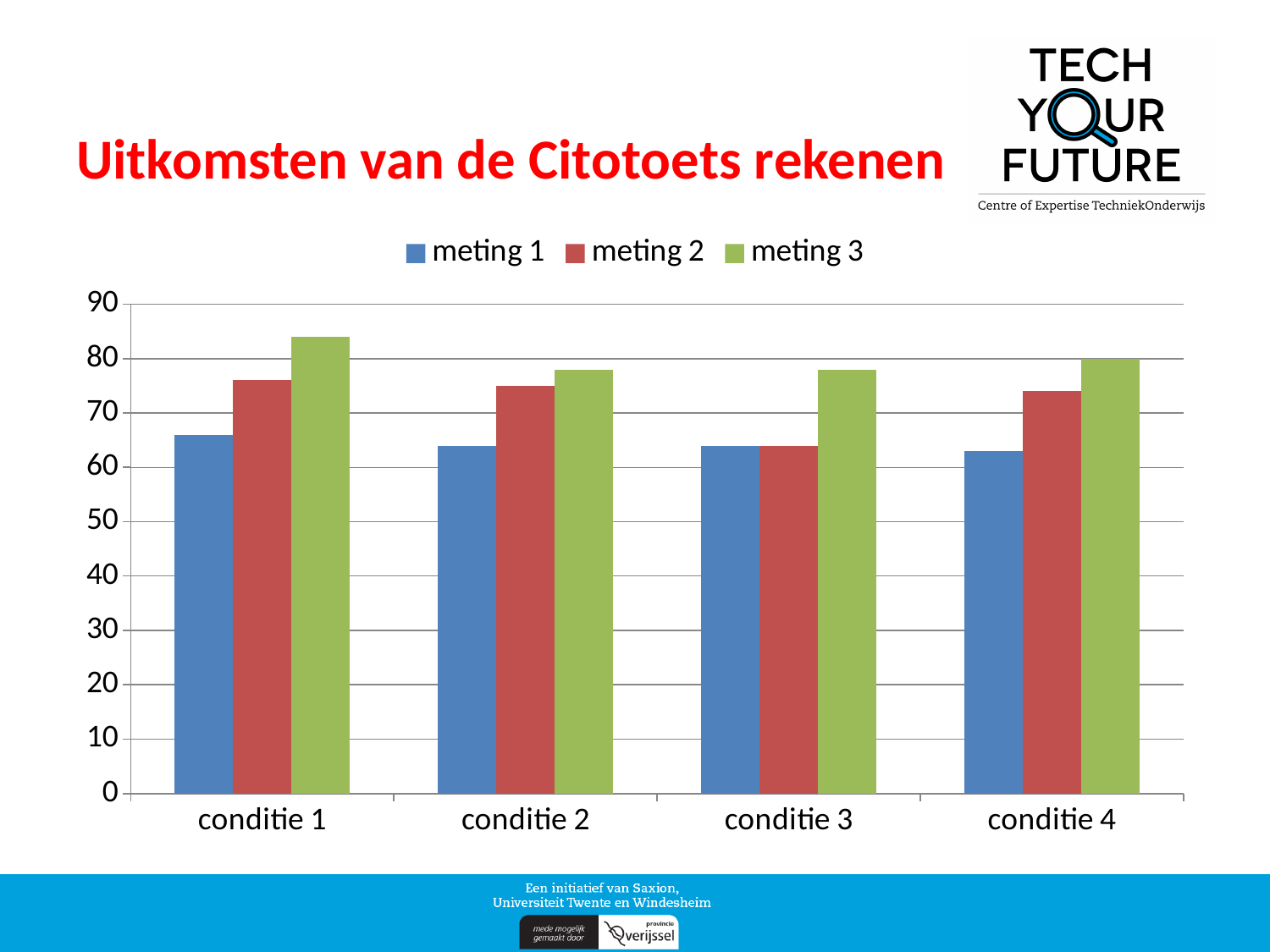
Which series has the lowest bar for conditie 2? meting 1 Which series has the highest bar for conditie 1? meting 3 Which is larger: meting 3 for conditie 1 or meting 3 for conditie 2? meting 3 for conditie 1 Is the value for meting 3 in conditie 3 greater or less than 80? less Is the value for meting 2 in conditie 2 greater or less than 70? greater Is the value for meting 1 in conditie 1 greater or less than 70? less How many series does the legend list? 3 What kind of chart is shown on the slide? bar chart Which is larger: meting 1 for conditie 4 or meting 2 for conditie 4? meting 2 for conditie 4 What is the title of the slide containing the chart? Uitkomsten van de Citotoets rekenen How many categories (condities) are shown on the x axis? 4